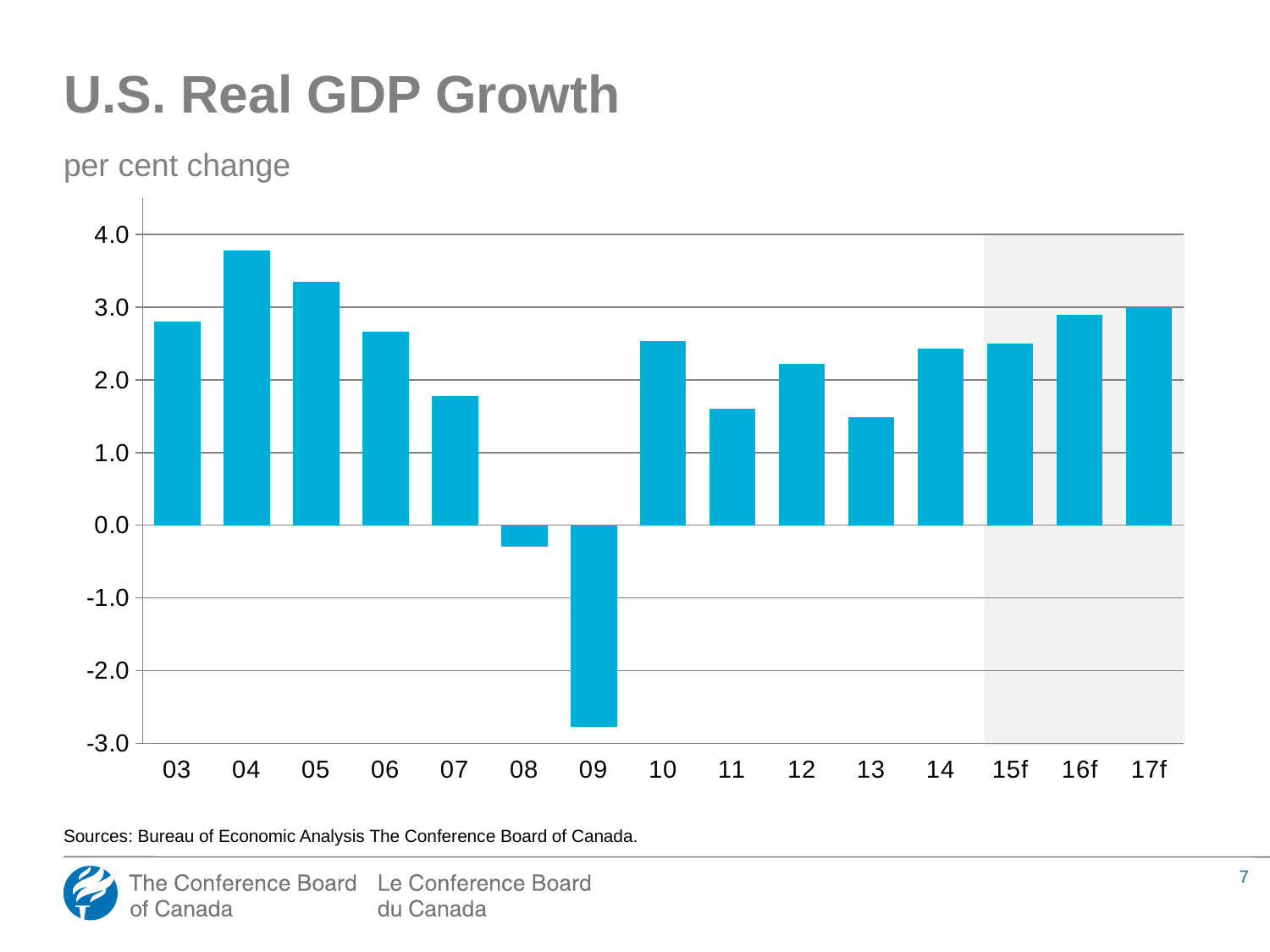
Which year has the lowest U.S. real GDP growth? 09 How many years are plotted on the x axis? 15 Which is larger, the value for 05 or the value for 06? 05 Do the values rise or fall from 14 to 17f? rise Which year has the highest U.S. real GDP growth? 04 What unit is given in the subtitle below the chart title? per cent change Is the value for 08 greater or less than 0.0? less Is the value for 07 greater or less than 2.0? less Is the value for 09 greater or less than -2.0? less What kind of chart is shown on the slide? bar chart Do the values rise or fall from 04 to 07? fall